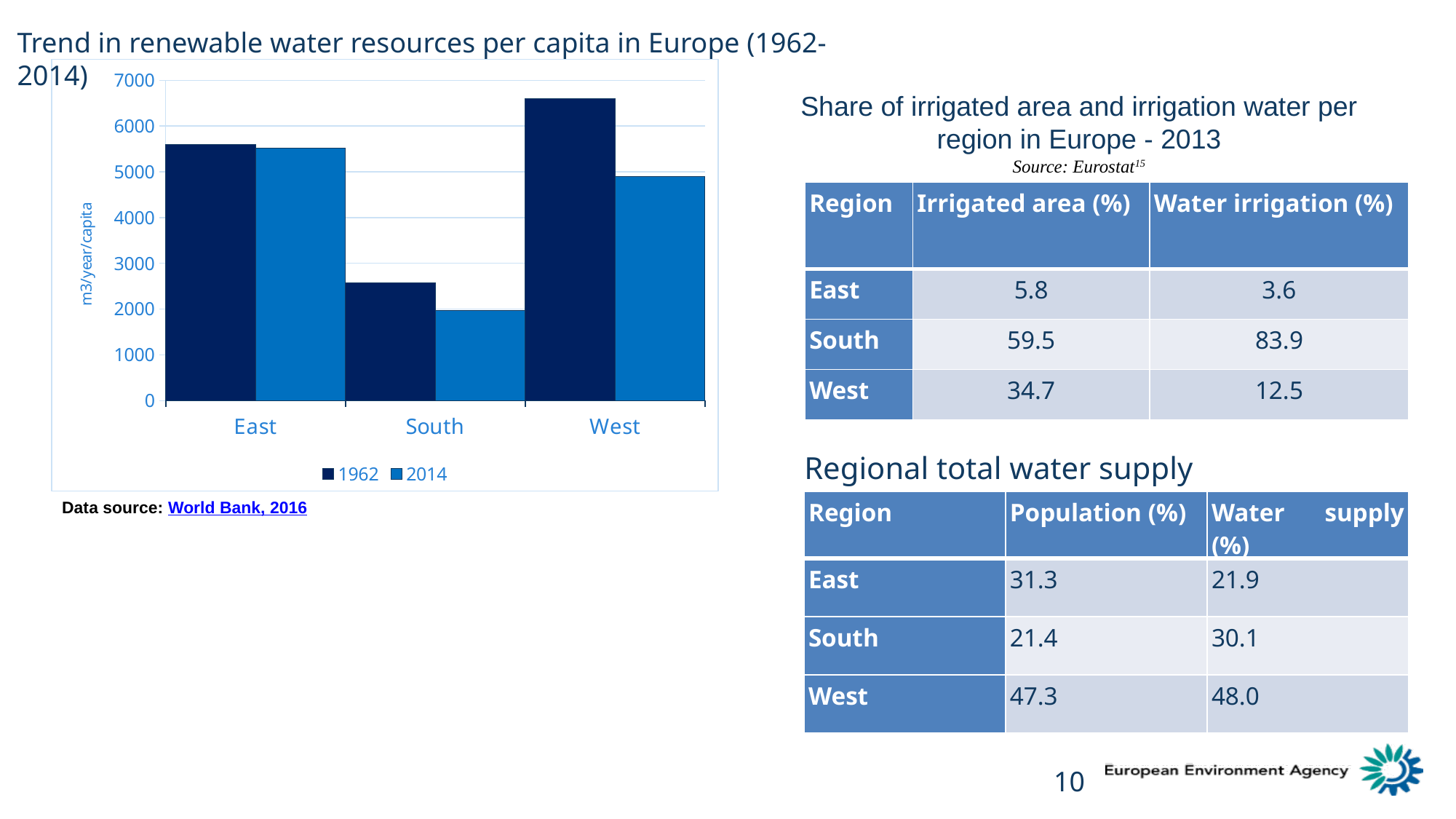
In the bar chart, which region has the highest value for 1962? West What kind of chart is shown on the left of the slide? bar chart In the bar chart, is the 2014 value for West greater or less than 6000? less In the bar chart, which is larger for West: the 1962 value or the 2014 value? 1962 In the bar chart, is the 1962 value for South greater or less than 3000? less In the bar chart, is the 1962 value for East greater or less than 5000? greater In the bar chart, which region has the lowest value for 1962? South In the bar chart, which region has the lowest value for 2014? South What unit is shown on the y axis of the bar chart? m3/year/capita How many regions are shown on the x axis of the bar chart? 3 How many series does the legend of the bar chart list? 2